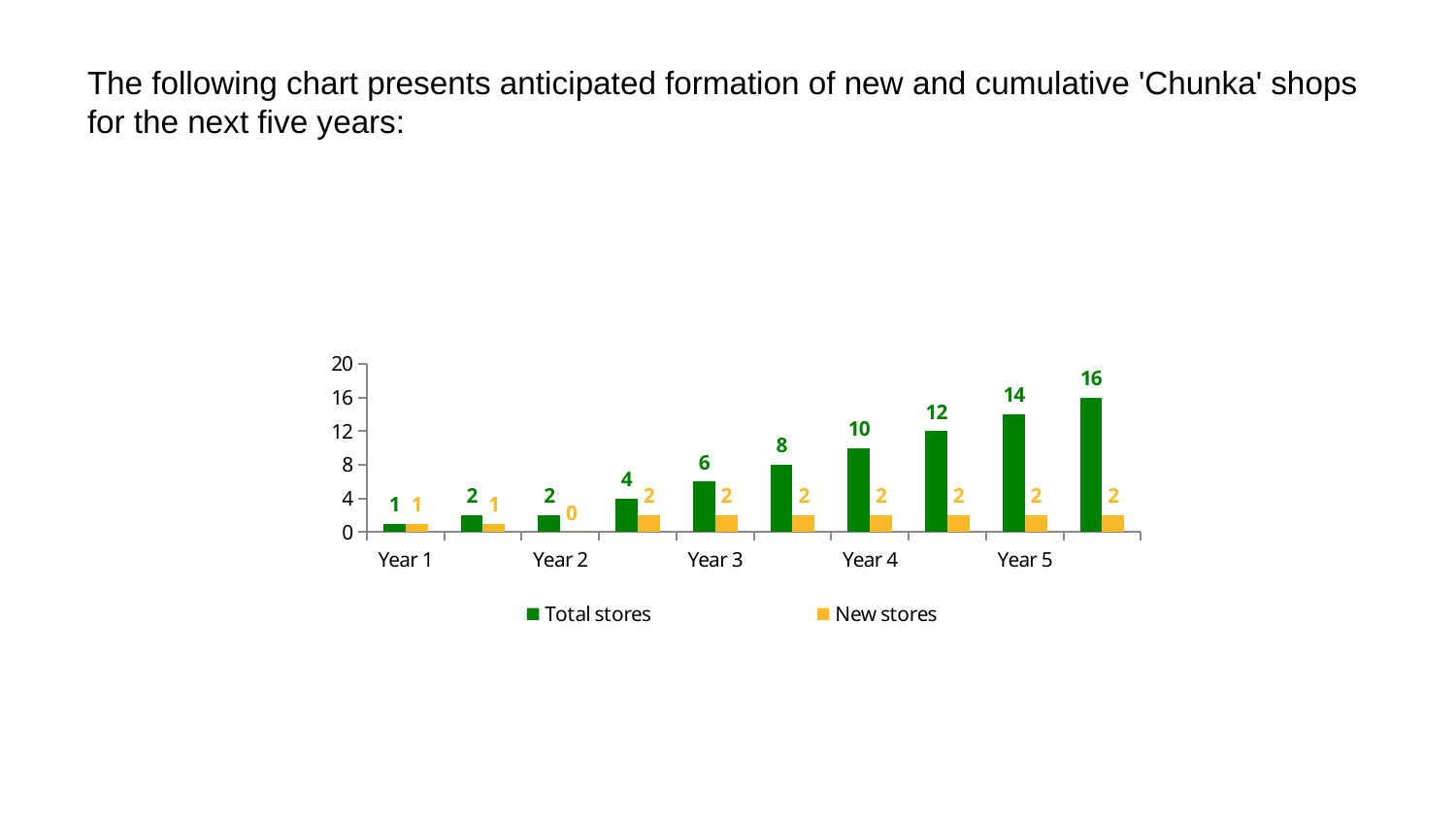
What is the highest value shown for the Total stores series? 16 What is the New stores value for the last (rightmost) bar group? 2 What is the difference between the highest and lowest Total stores values? 15 What is the lowest value shown for the New stores series? 0 How many year labels appear on the x axis? 5 How many series does the legend list? 2 Which is larger: the Total stores value in the first bar group or in the last bar group? The last bar group Do the Total stores values rise or fall from Year 1 to Year 5? Rise What kind of chart is shown on the slide? Bar chart What is the lowest value shown for the Total stores series? 1 Is the highest Total stores value greater or less than 12? greater What is the Total stores value for the last (rightmost) bar group? 16